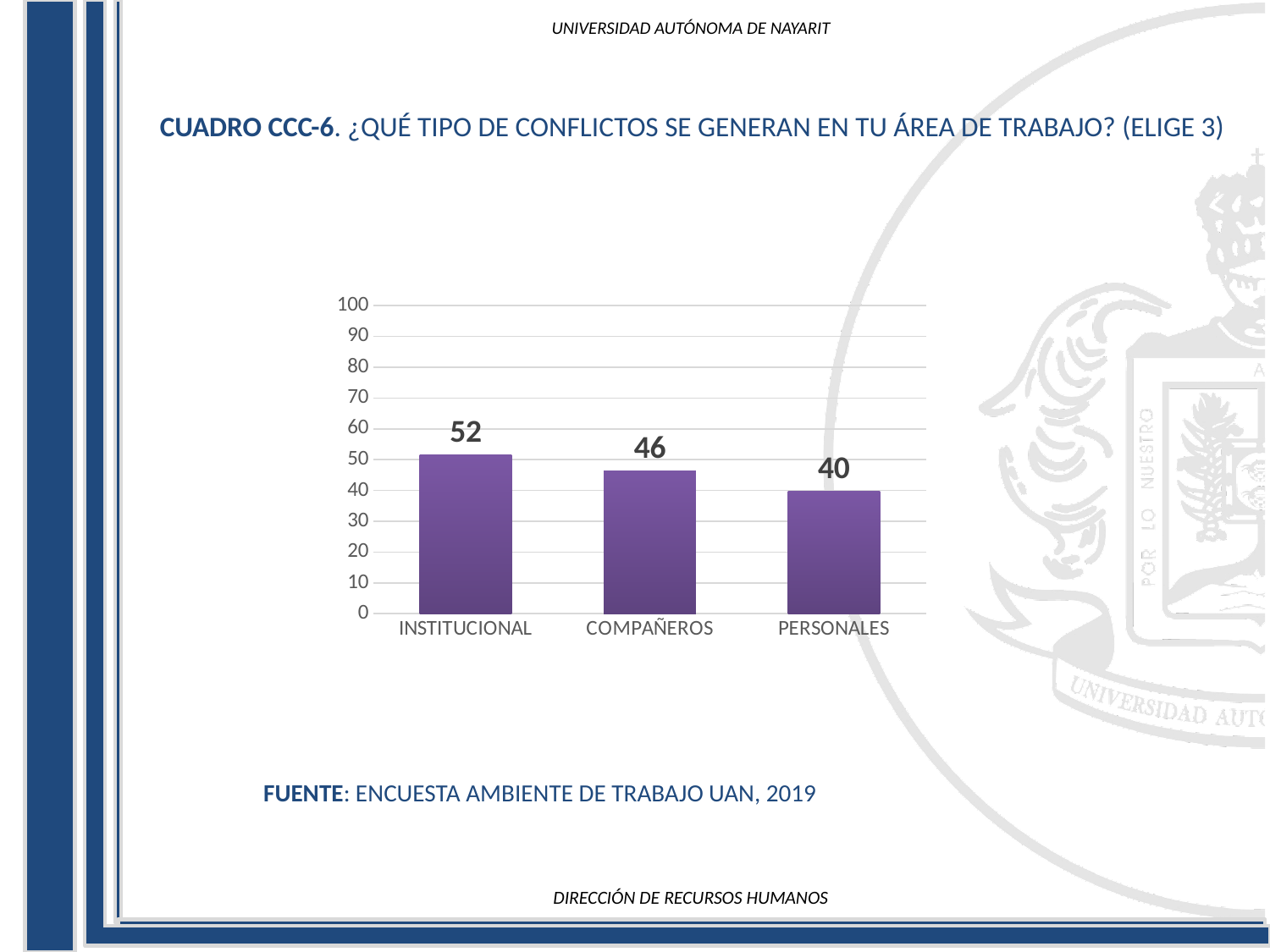
Which category has the lowest value? PERSONALES What is the value for INSTITUCIONAL? 52 How many categories are shown on the x axis? 3 What is the difference between the values for COMPAÑEROS and PERSONALES? 6 What is the value for PERSONALES? 40 What is the difference between the values for INSTITUCIONAL and PERSONALES? 12 Do the values rise or fall from left to right along the x axis? fall What kind of chart is shown on the slide? bar chart Which category has the highest value? INSTITUCIONAL Is the value for INSTITUCIONAL greater or less than 50? greater What is the value for COMPAÑEROS? 46 Which is larger, the value for COMPAÑEROS or the value for PERSONALES? COMPAÑEROS